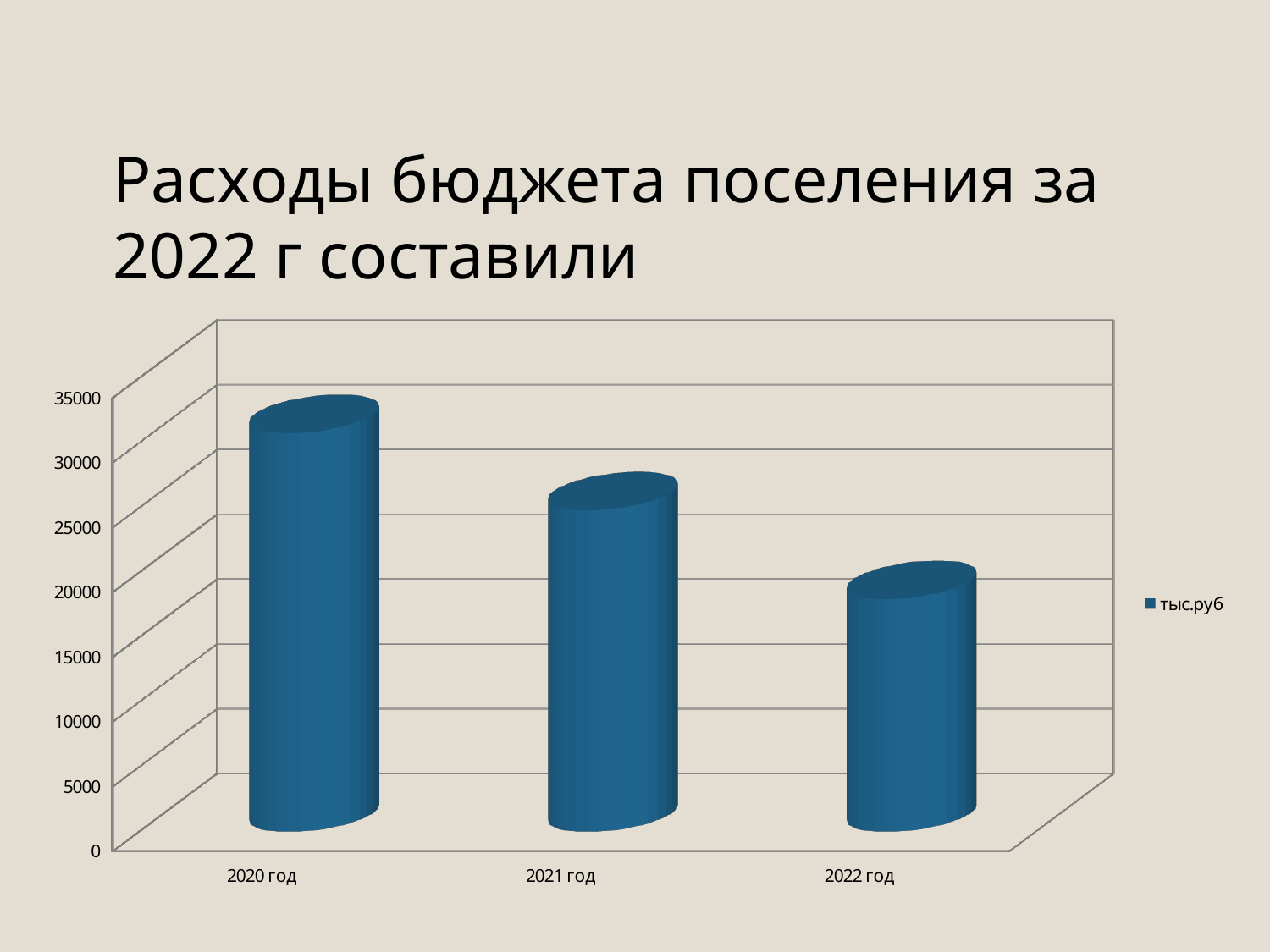
Is the value for 2021 год greater or less than 30000? less How many categories (years) are shown on the x axis? 3 Is the value for 2022 год greater or less than 25000? less Do the values rise or fall from 2020 год to 2022 год? fall How many series does the legend list? 1 Which year has the lowest bar? 2022 год Which year has the highest bar? 2020 год Is the value for 2022 год greater or less than 15000? greater Which is larger, the value for 2021 год or the value for 2022 год? 2021 год What is the legend entry of the series shown in the chart? тыс.руб What kind of chart is shown on the slide? bar chart